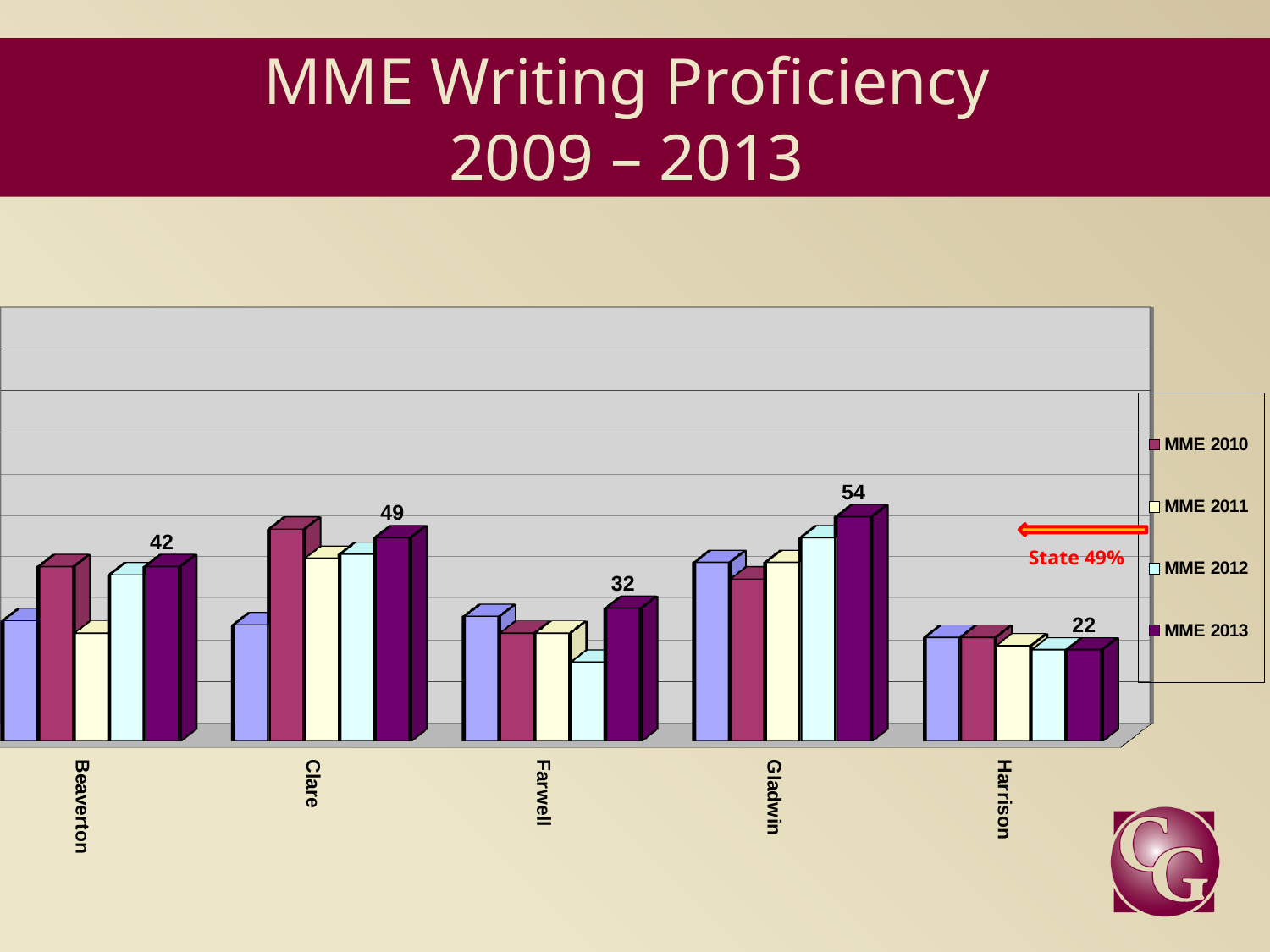
What is the MME 2013 value for Farwell? 32 Which district has the lowest MME 2013 value? Harrison What is the MME 2013 value for Clare? 49 What is the difference between the MME 2013 values for Gladwin and Harrison? 32 Which district has the highest MME 2013 value? Gladwin What is the MME 2013 value for Gladwin? 54 Which has the larger MME 2013 value, Beaverton or Farwell? Beaverton What kind of chart is shown on the slide? Bar chart What is the MME 2013 value for Beaverton? 42 What state percentage is indicated by the red arrow annotation? 49% What is the MME 2013 value for Harrison? 22 How many districts are shown on the x axis? 5